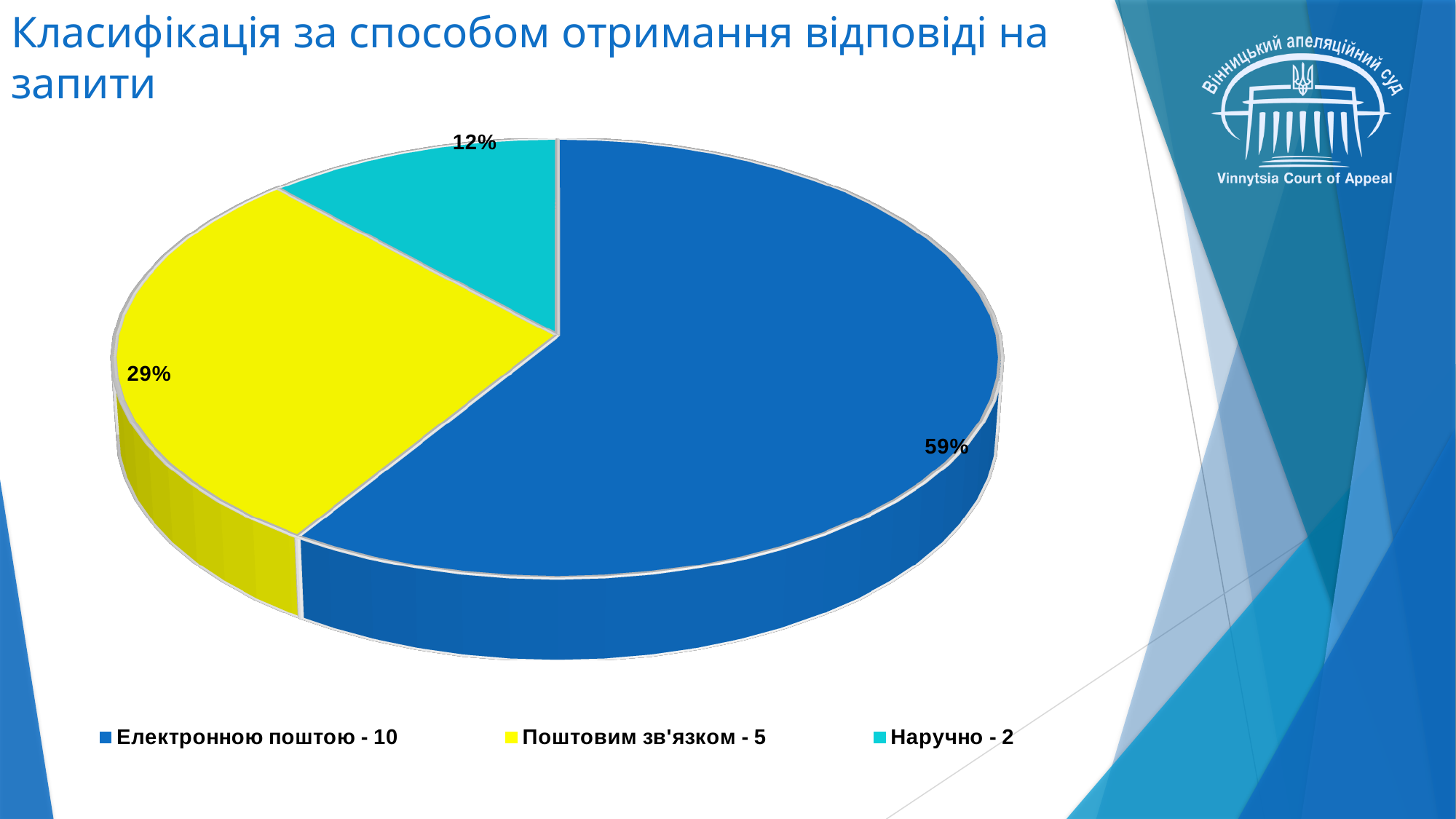
How many entries does the legend list? 3 Which category has the largest slice of the pie? Електронною поштою - 10 What percentage share does the slice "Наручно - 2" have? 12% Which slice is larger: "Поштовим зв'язком - 5" or "Наручно - 2"? Поштовим зв'язком - 5 How many slices does the pie chart have? 3 What is the title of the slide containing the chart? Класифікація за способом отримання відповіді на запити Which category has the smallest slice of the pie? Наручно - 2 What kind of chart is shown on the slide? Pie chart What percentage share does the slice "Електронною поштою - 10" have? 59% What is the difference in percentage points between the "Електронною поштою - 10" slice and the "Поштовим зв'язком - 5" slice? 30% What percentage share does the slice "Поштовим зв'язком - 5" have? 29% What colour is the slice for "Поштовим зв'язком - 5"? Yellow